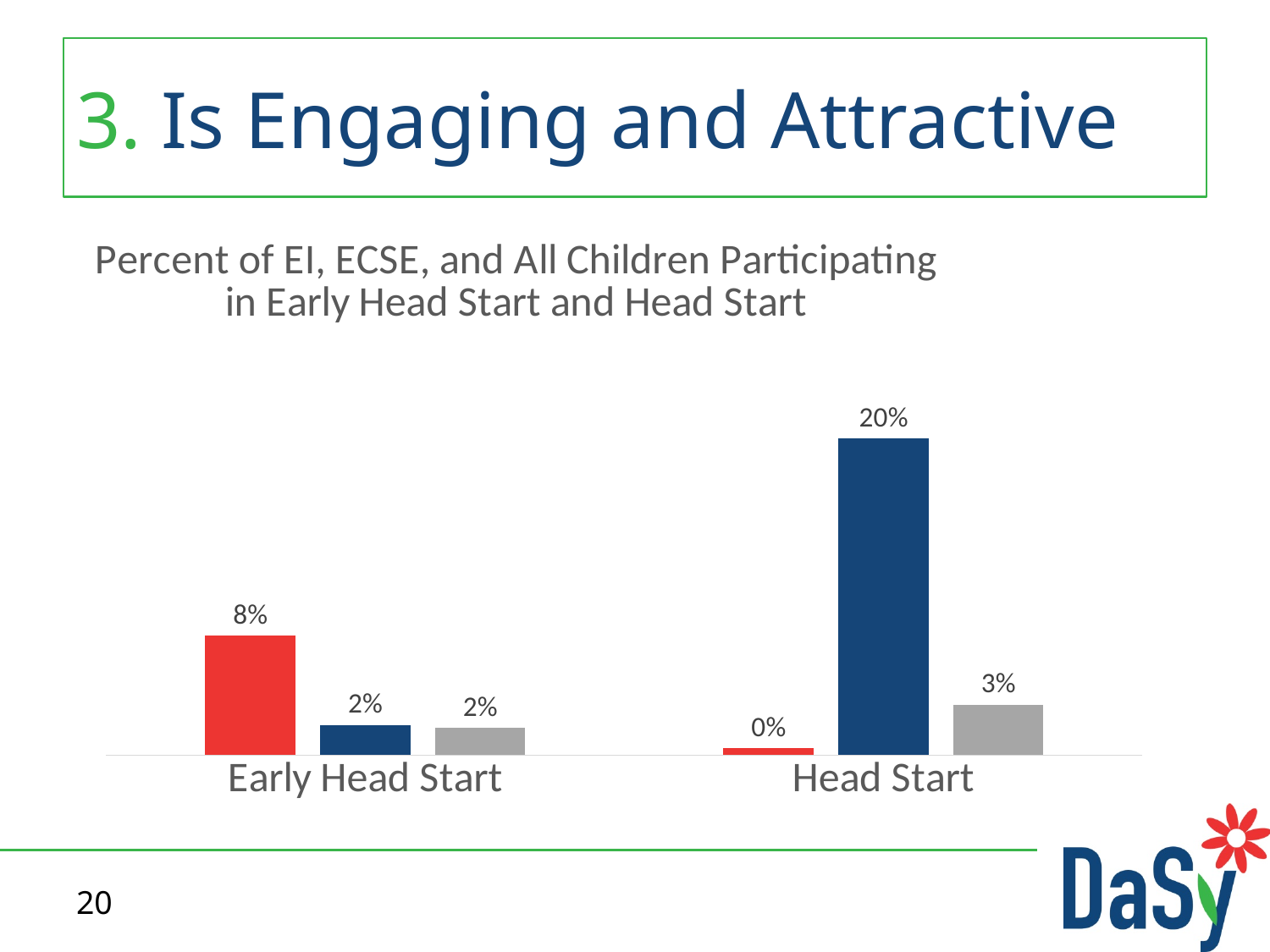
Which is larger, the gray bar for Head Start or the gray bar for Early Head Start? The gray bar for Head Start Which bar has the lowest value on the chart? The red bar for Head Start Which bar has the highest value on the chart? The blue bar for Head Start What is the value of the blue bar for Early Head Start? 2% How many categories are shown on the x axis? 2 What is the difference between the red bar for Early Head Start and the red bar for Head Start? 8% What is the value of the red bar for Head Start? 0% What is the difference between the blue bar for Head Start and the blue bar for Early Head Start? 18% What is the value of the gray bar for Head Start? 3% What is the value of the blue bar for Head Start? 20% What type of chart is shown on the slide? Bar chart What is the value of the red bar for Early Head Start? 8%